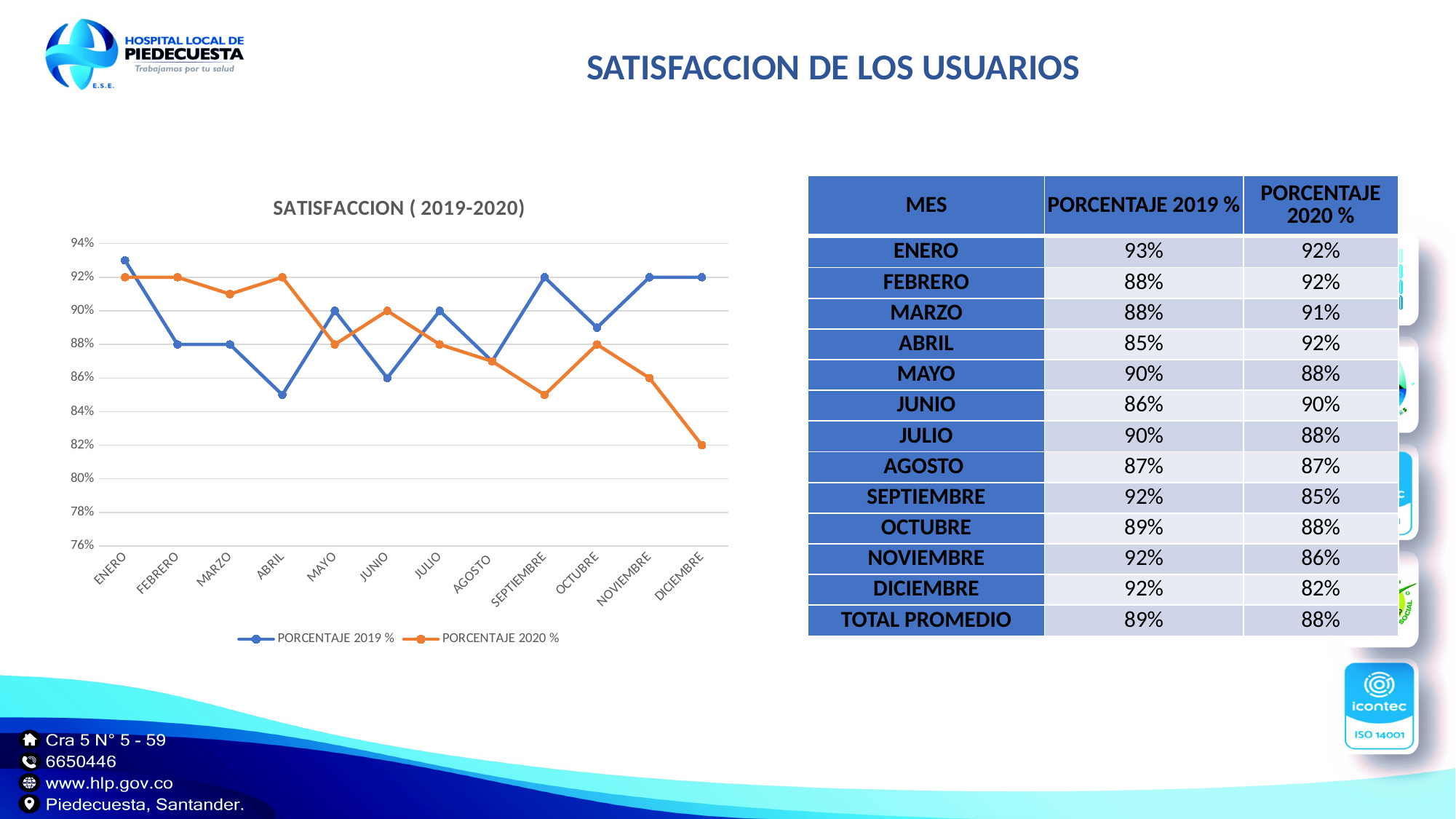
Which month has the lowest PORCENTAJE 2019 % value? ABRIL In SEPTIEMBRE, which series has the larger value, PORCENTAJE 2019 % or PORCENTAJE 2020 %? PORCENTAJE 2019 % What is the PORCENTAJE 2019 % value for ENERO? 93% Which month has the lowest PORCENTAJE 2020 % value? DICIEMBRE Does the PORCENTAJE 2020 % series rise or fall from OCTUBRE to DICIEMBRE? fall How many months are plotted along the x axis of the SATISFACCION ( 2019-2020) chart? 12 What is the difference between the PORCENTAJE 2019 % and PORCENTAJE 2020 % values for DICIEMBRE? 10% Which month has the highest PORCENTAJE 2019 % value? ENERO What is the PORCENTAJE 2020 % value for JUNIO? 90% What is the PORCENTAJE 2020 % value for DICIEMBRE? 82% What type of chart is shown under the title SATISFACCION ( 2019-2020)? line chart How many series does the legend of the SATISFACCION ( 2019-2020) chart list? 2